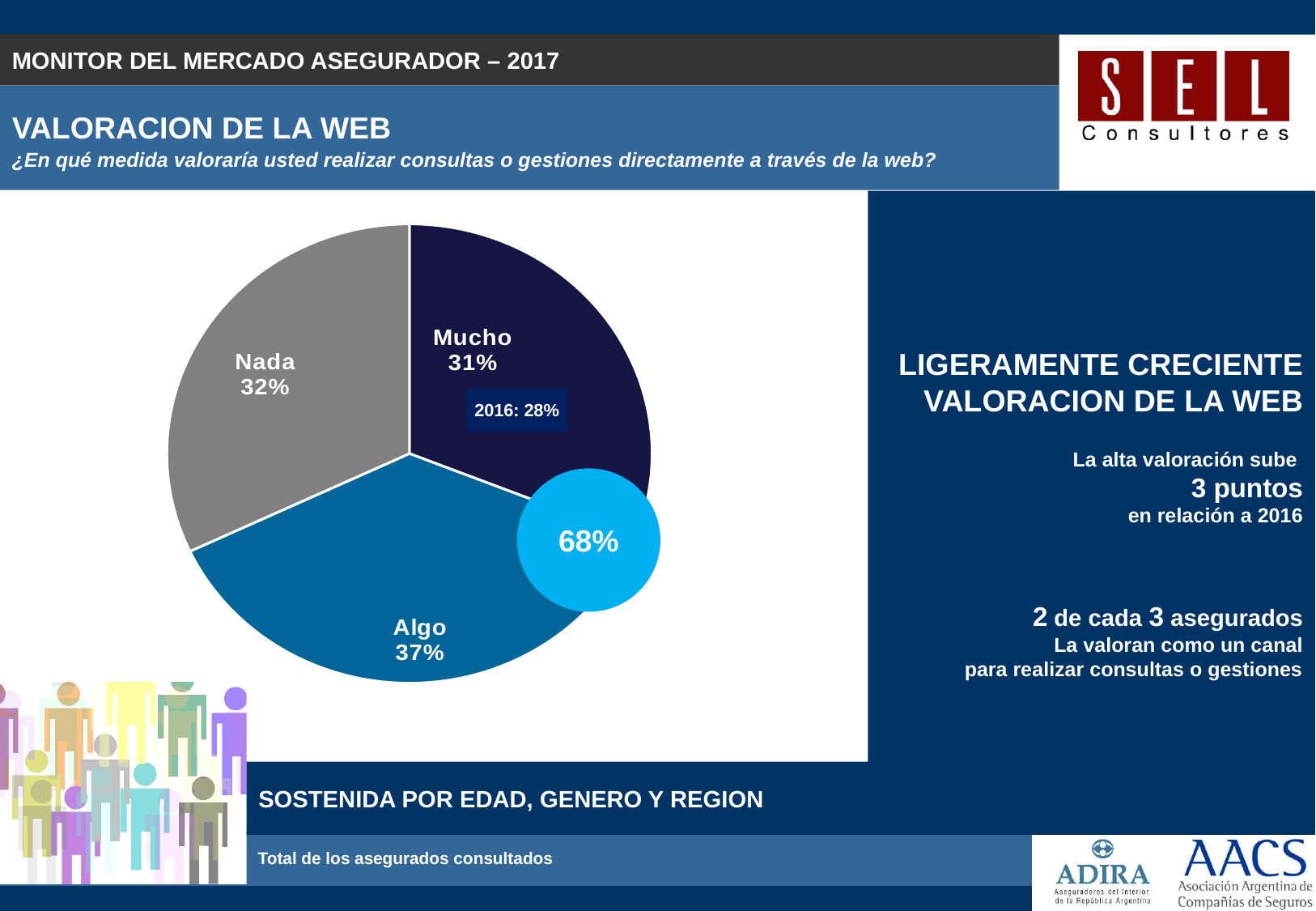
What is the value for Algo in the pie chart? 37% What is the value for Nada in the pie chart? 32% What is the value for Mucho in the pie chart? 31% Which is larger, the Nada slice or the Mucho slice? Nada How many slices does the pie chart have? 3 What combined percentage is shown in the light blue circle next to the pie chart? 68% What colour is the Nada slice of the pie chart? grey Which category has the largest slice in the pie chart? Algo Which category has the smallest slice in the pie chart? Mucho What was the 2016 value shown for Mucho? 28% What is the difference between the Algo and Mucho slices? 6 percentage points What type of chart is shown on the slide? pie chart